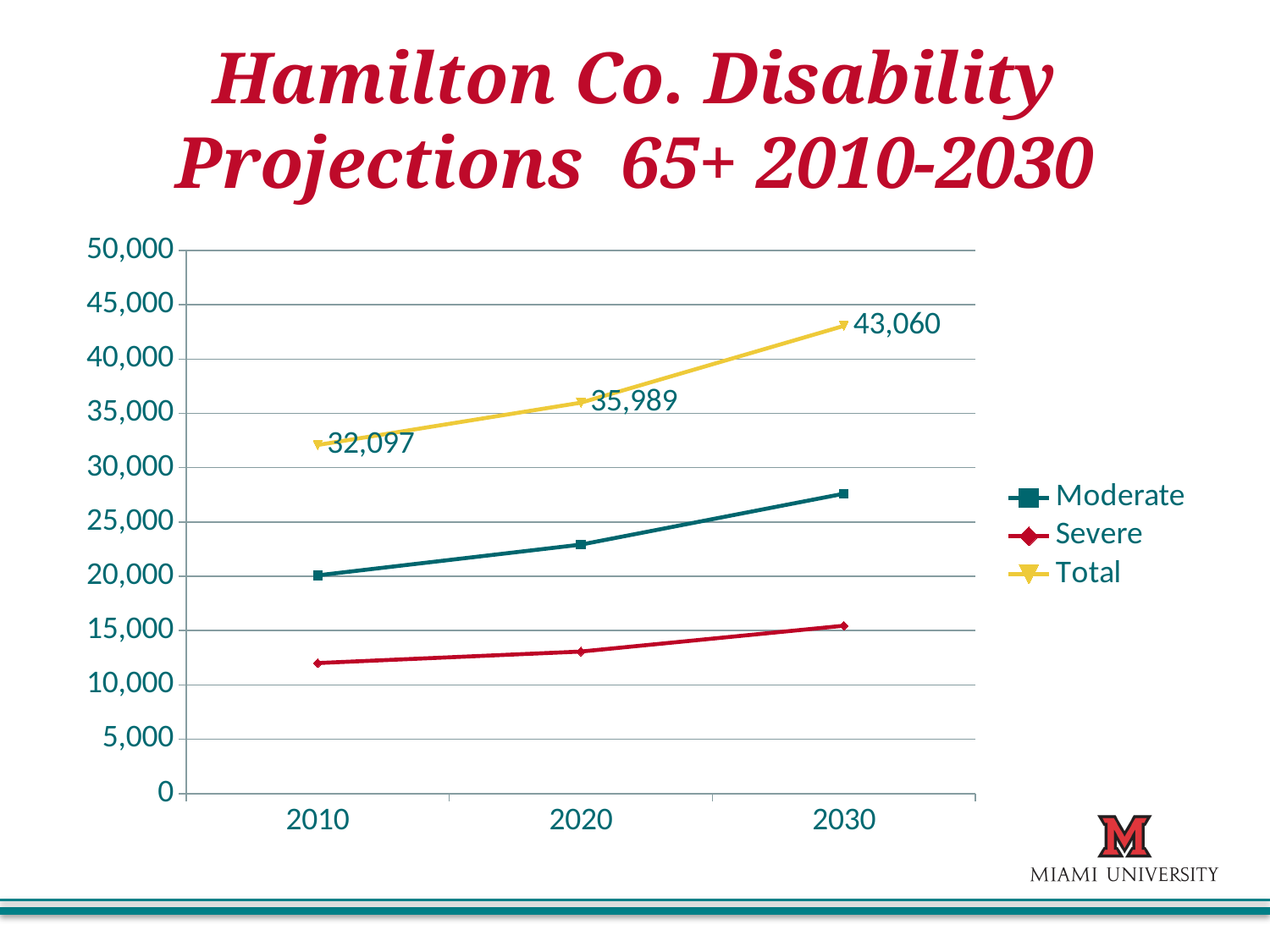
How many series does the legend list? 3 By how much does the Total increase from 2010 to 2030? 10,963 What is the Total value for 2010? 32,097 What is the Total value for 2020? 35,989 What is the difference between the Total values for 2020 and 2010? 3,892 Does the Total series rise or fall from 2010 to 2030? Rise In which year is the Total value highest? 2030 What is the Total value for 2030? 43,060 How many years are plotted on the x axis? 3 Is the value for Moderate in 2030 greater or less than 25,000? greater Which series has the larger value in 2020, Moderate or Severe? Moderate What kind of chart is shown on the slide? Line chart